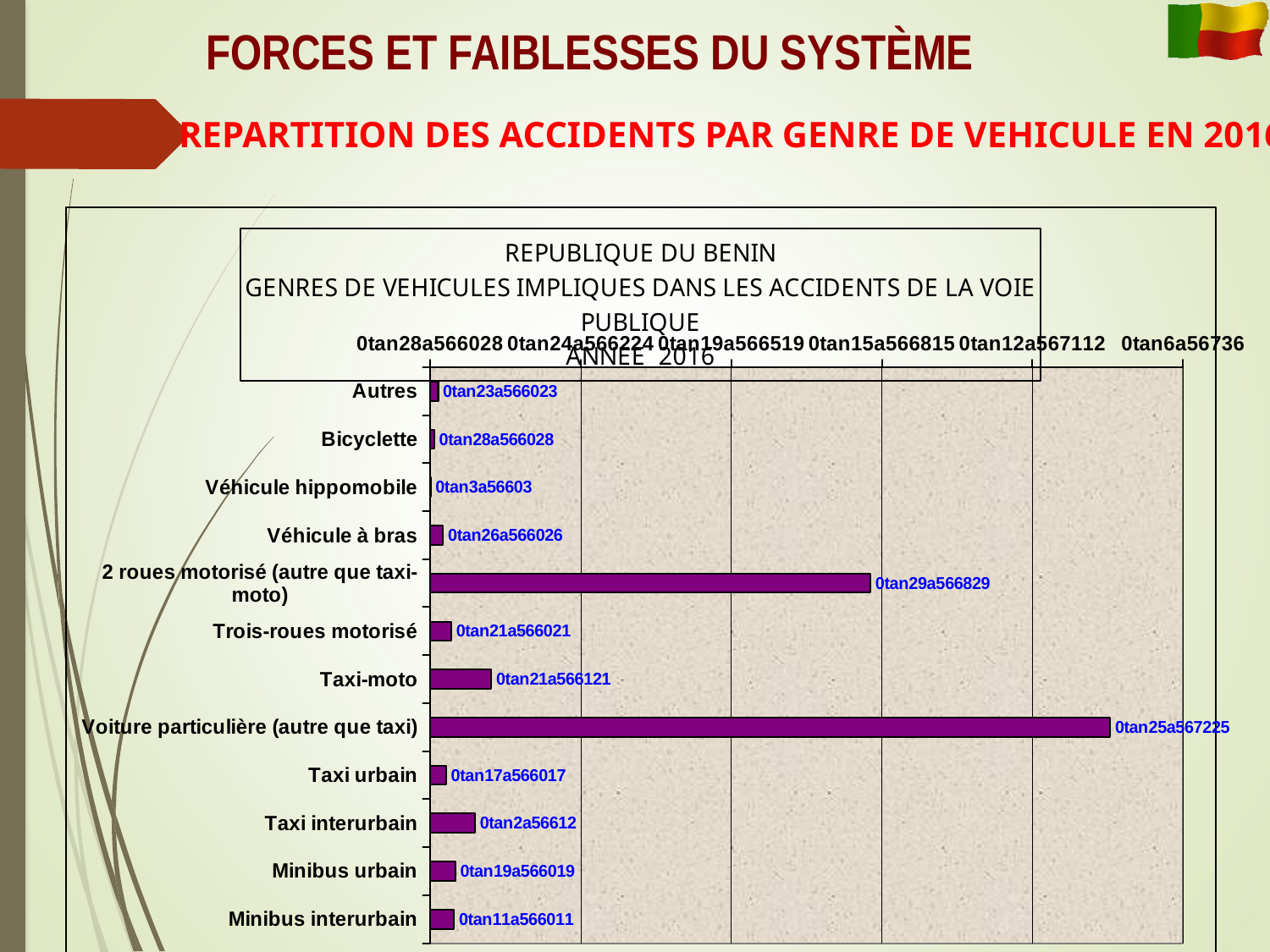
Which vehicle category has the shortest bar in the chart? Véhicule hippomobile Which has the longer bar, 2 roues motorisé (autre que taxi-moto) or Taxi-moto? 2 roues motorisé (autre que taxi-moto) Which vehicle category has the longest bar in the chart? Voiture particulière (autre que taxi) What colour are the bars in the chart? purple Which vehicle category has the second-longest bar in the chart? 2 roues motorisé (autre que taxi-moto) Which has the longer bar, Voiture particulière (autre que taxi) or 2 roues motorisé (autre que taxi-moto)? Voiture particulière (autre que taxi) What year is stated in the chart title? 2016 How many vehicle categories are plotted in the chart? 12 What kind of chart is shown on the slide? bar chart Which has the longer bar, Trois-roues motorisé or Autres? Trois-roues motorisé